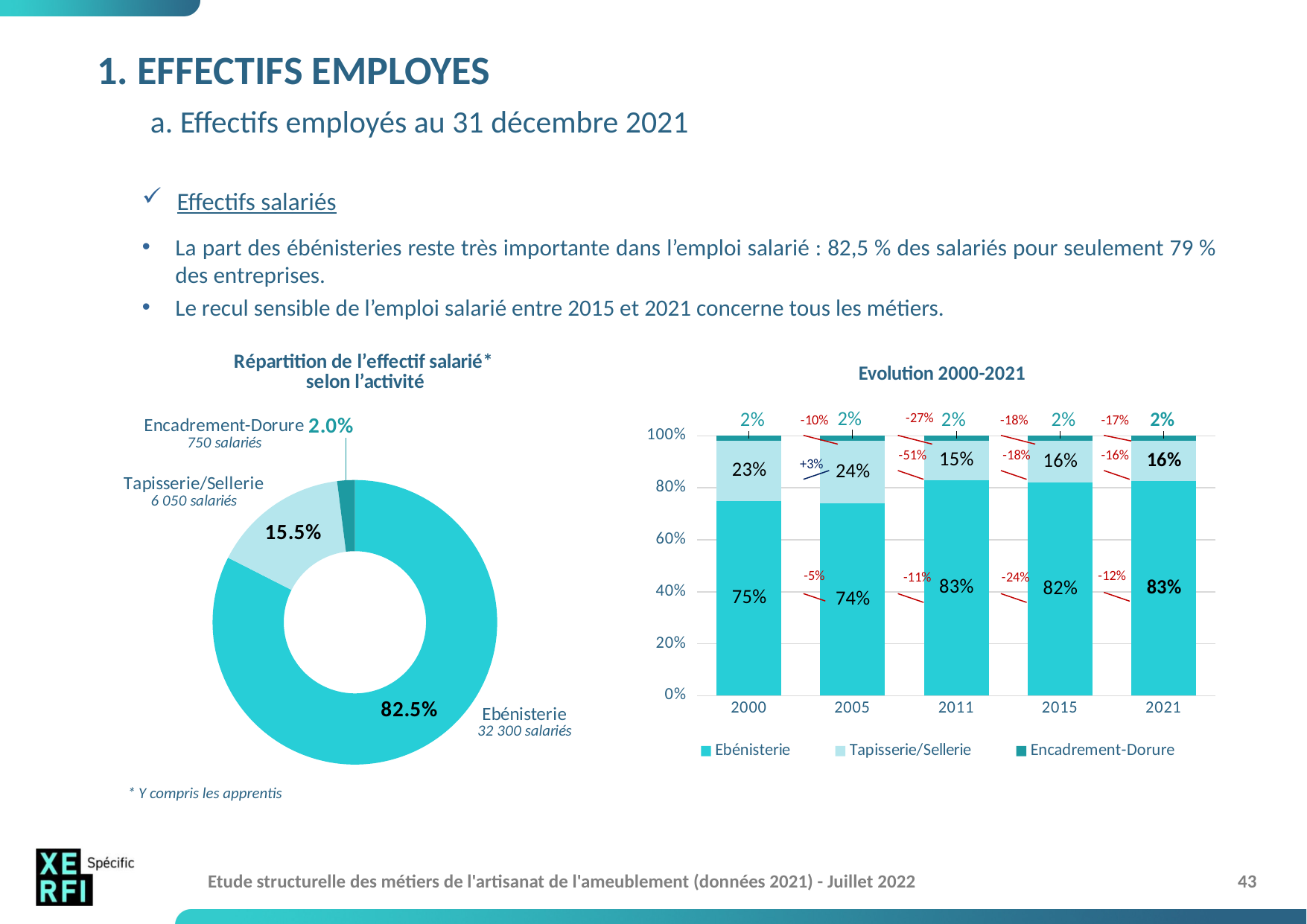
In the chart 'Evolution 2000-2021', what is the value for Tapisserie/Sellerie in 2000? 23% In the chart 'Evolution 2000-2021', how many years are shown on the x axis? 5 In the chart 'Répartition de l'effectif salarié selon l'activité', which activity has the smallest share? Encadrement-Dorure In the chart 'Répartition de l'effectif salarié selon l'activité', how many salariés are shown for Encadrement-Dorure? 750 salariés In the chart 'Répartition de l'effectif salarié selon l'activité', how many activities are shown? 3 What kind of chart is 'Répartition de l'effectif salarié selon l'activité'? Donut (pie) chart In the chart 'Evolution 2000-2021', what is the difference between the Ebénisterie share in 2021 and in 2000? 8 percentage points In the chart 'Répartition de l'effectif salarié selon l'activité', what share does Tapisserie/Sellerie represent? 15.5% In the chart 'Répartition de l'effectif salarié selon l'activité', what share of salaried employees does Ebénisterie represent? 82.5% In the chart 'Evolution 2000-2021', which year has the highest Tapisserie/Sellerie share? 2005 In the chart 'Evolution 2000-2021', how many series does the legend list? 3 In the chart 'Evolution 2000-2021', what is the value for Ebénisterie in 2005? 74%